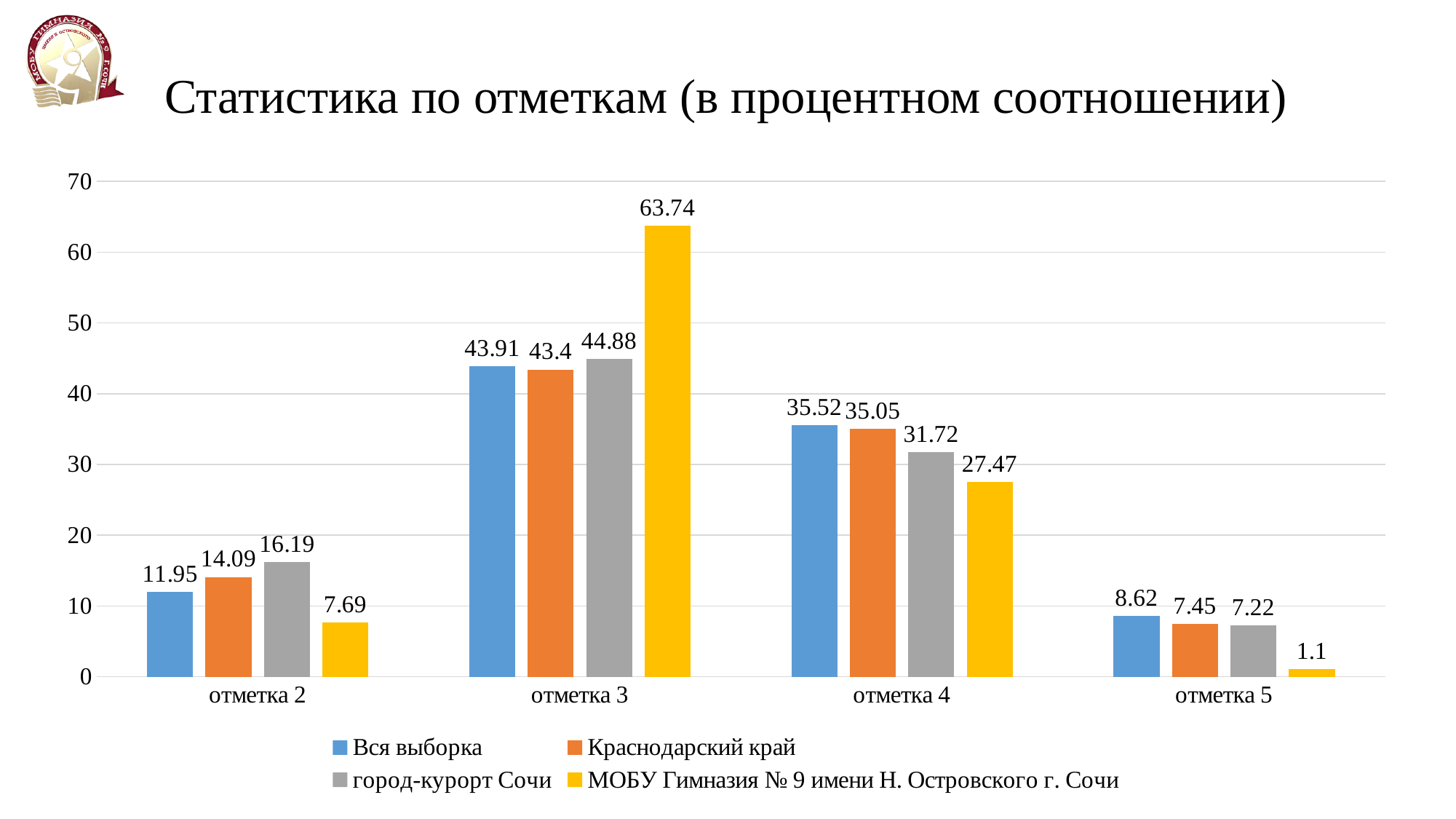
What kind of chart is shown on the slide? bar chart At отметка 4, which is larger: Вся выборка or МОБУ Гимназия № 9? Вся выборка What is the value for МОБУ Гимназия № 9 имени Н. Островского г. Сочи at отметка 3? 63.74 What is the title of the chart on the slide? Статистика по отметкам (в процентном соотношении) Which category has the lowest value for the Вся выборка series? отметка 5 How many categories are shown on the x axis? 4 What is the difference between the МОБУ Гимназия № 9 value and the Вся выборка value at отметка 3? 19.83 How many series does the legend list? 4 What is the value for Краснодарский край at отметка 5? 7.45 Which category has the highest value for the МОБУ Гимназия № 9 series? отметка 3 What is the value for город-курорт Сочи at отметка 4? 31.72 What is the value for Вся выборка at отметка 2? 11.95